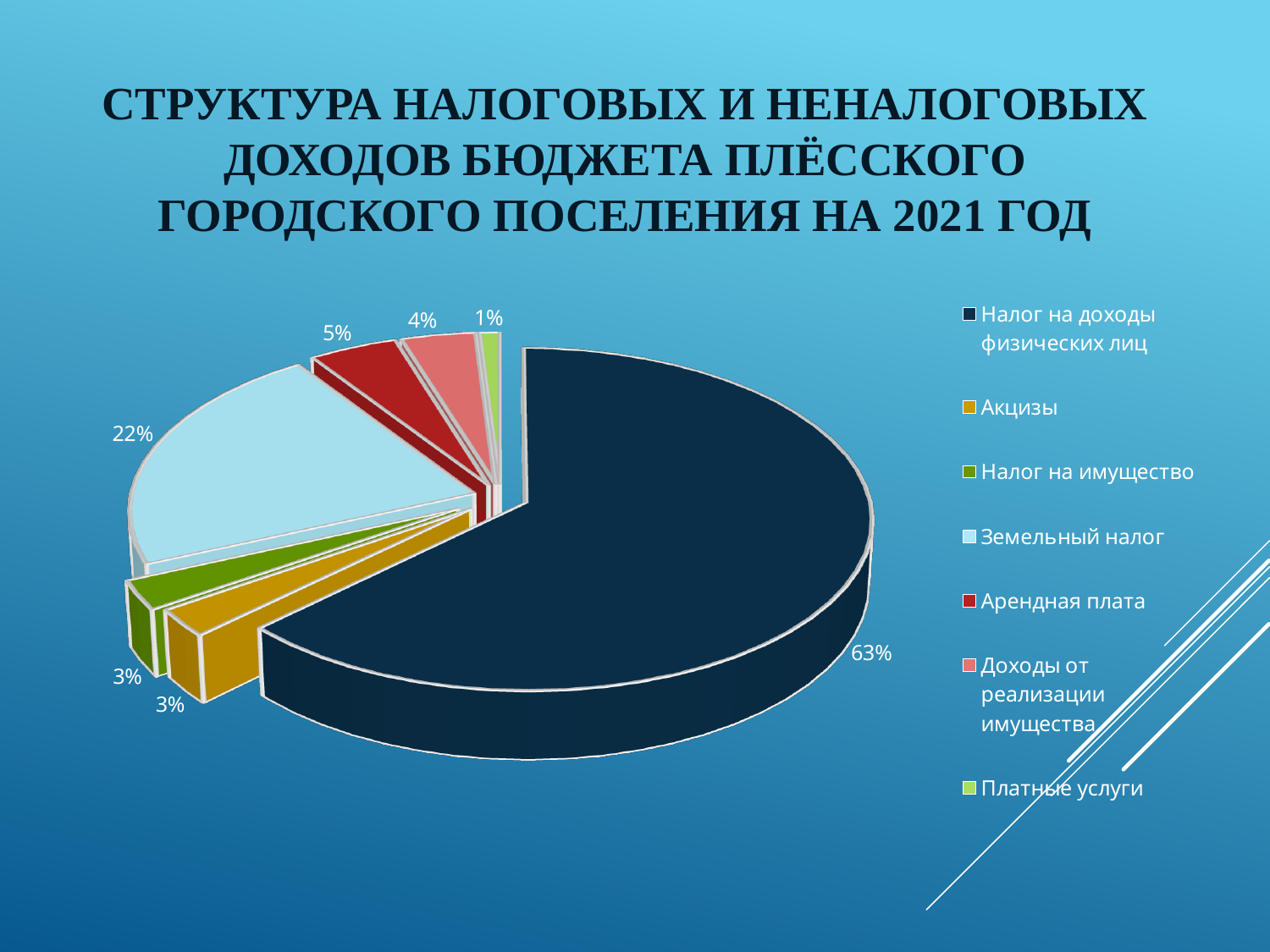
What kind of chart is shown on the slide? pie chart What share of the pie does Налог на доходы физических лиц have? 63% Which category has the largest share of the pie? Налог на доходы физических лиц What share of the pie does Арендная плата have? 5% How many categories does the legend list? 7 Which category has the smallest share of the pie? Платные услуги Which is larger, the share of Арендная плата or the share of Доходы от реализации имущества? Арендная плата What share of the pie does Платные услуги have? 1% What share of the pie does Доходы от реализации имущества have? 4% What share of the pie does Земельный налог have? 22% What share of the pie does Акцизы have? 3% What is the difference between the shares of Налог на доходы физических лиц and Земельный налог? 41%